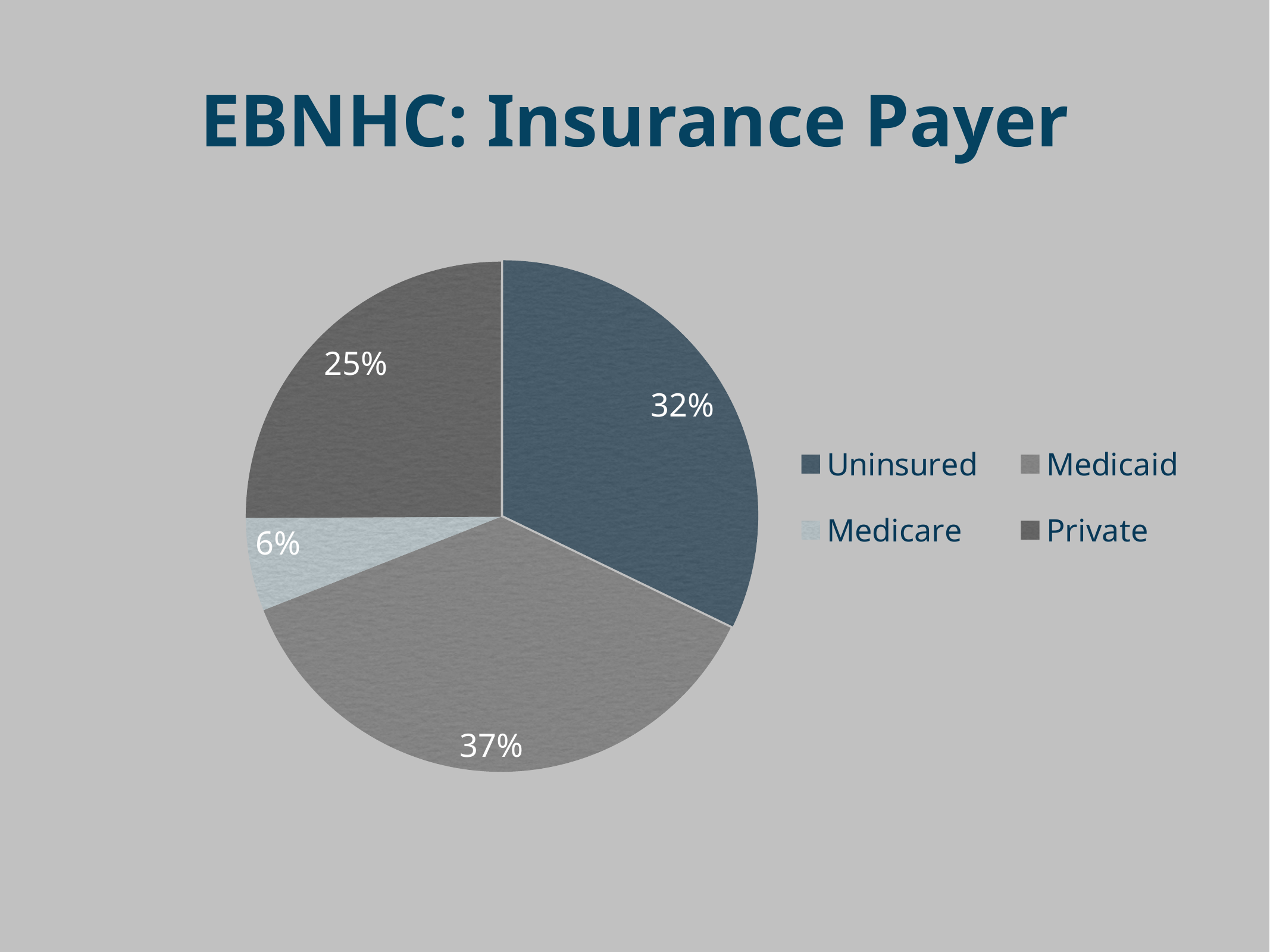
What share of the pie is Medicaid? 37% What is the title of the chart? EBNHC: Insurance Payer What is the difference between the Private share and the Medicare share? 19% What share of the pie is Uninsured? 32% What share of the pie is Medicare? 6% What kind of chart is shown on the slide? pie chart Which payer category has the smallest share? Medicare What is the difference between the Medicaid share and the Uninsured share? 5% Which is larger, the Private share or the Medicare share? Private What share of the pie is Private? 25% Which payer category has the largest share? Medicaid How many categories does the legend list? 4